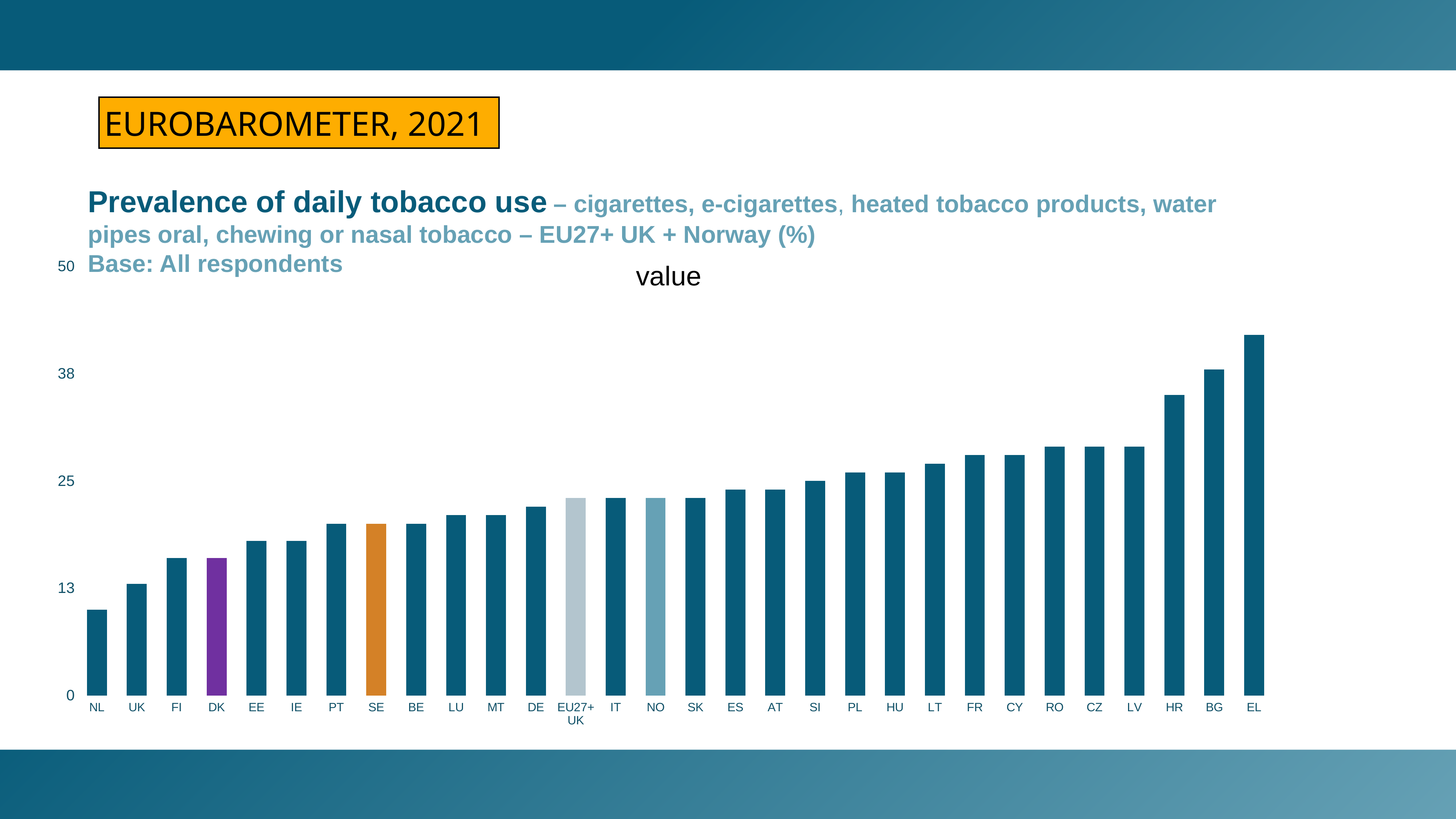
Is the value for EL greater or less than 38? greater What colour is the bar for DK? purple Do the values rise or fall moving from left to right along the x axis? rise Is the value for NL greater or less than 13? less Is the value for HR greater or less than 38? less Which has a larger value, HR or DK? HR Which country has the lowest prevalence of daily tobacco use in the chart? NL Which country has the highest prevalence of daily tobacco use in the chart? EL What kind of chart is shown on the slide? bar chart How many categories are shown along the x axis of the chart? 30